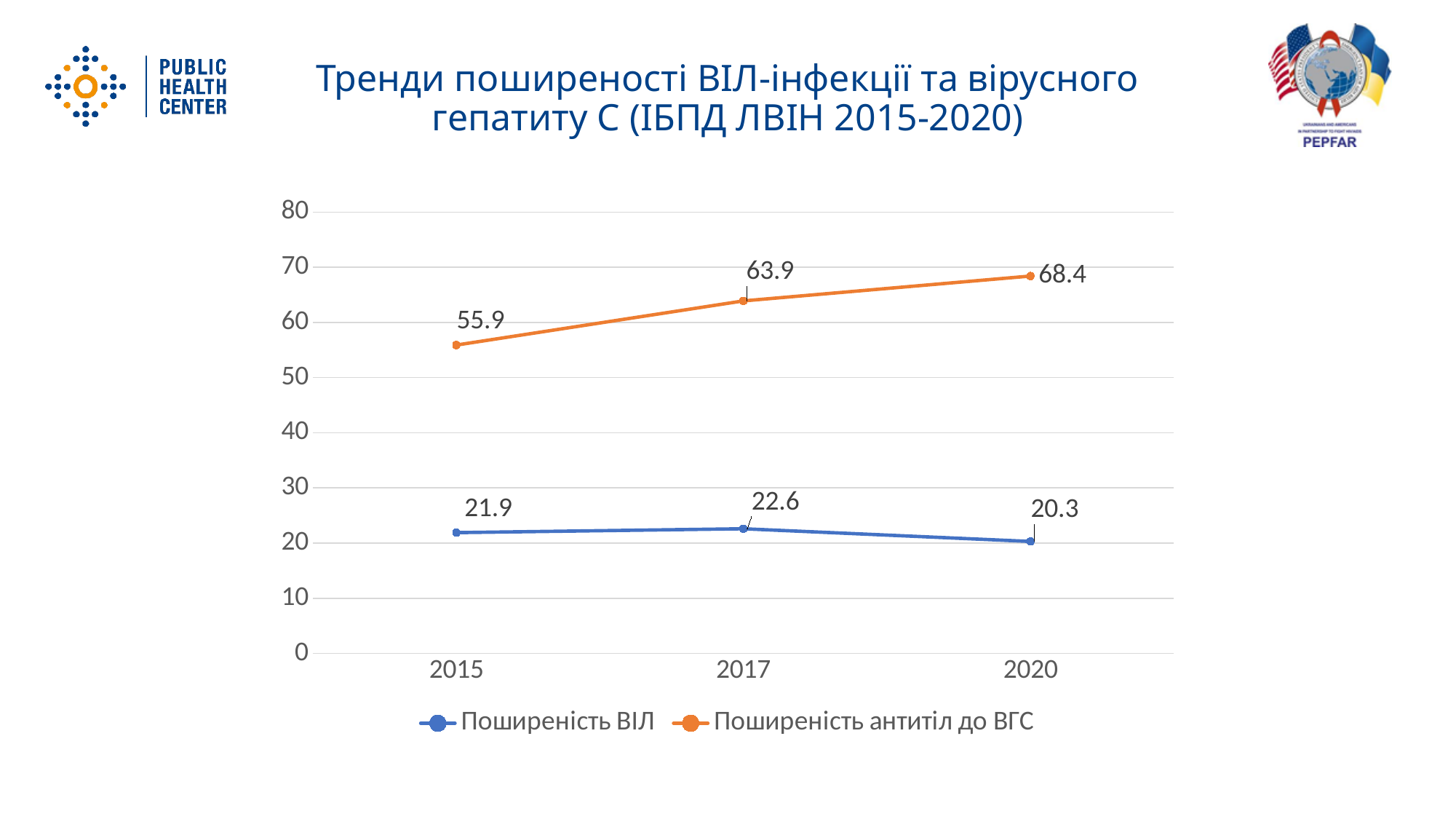
What is the value for Поширеність антитіл до ВГС in 2017? 63.9 Is the value for Поширеність антитіл до ВГС in 2015 greater or less than 50? greater In which year is Поширеність антитіл до ВГС highest? 2020 In which year is Поширеність ВІЛ lowest? 2020 What is the difference between Поширеність антитіл до ВГС in 2020 and in 2015? 12.5 How many series does the legend list? 2 What is the value for Поширеність ВІЛ in 2015? 21.9 What kind of chart is shown on the slide? line chart What is the value for Поширеність ВІЛ in 2020? 20.3 Which is larger in 2017: Поширеність ВІЛ or Поширеність антитіл до ВГС? Поширеність антитіл до ВГС How many years are shown on the x axis? 3 What is the value for Поширеність антитіл до ВГС in 2020? 68.4